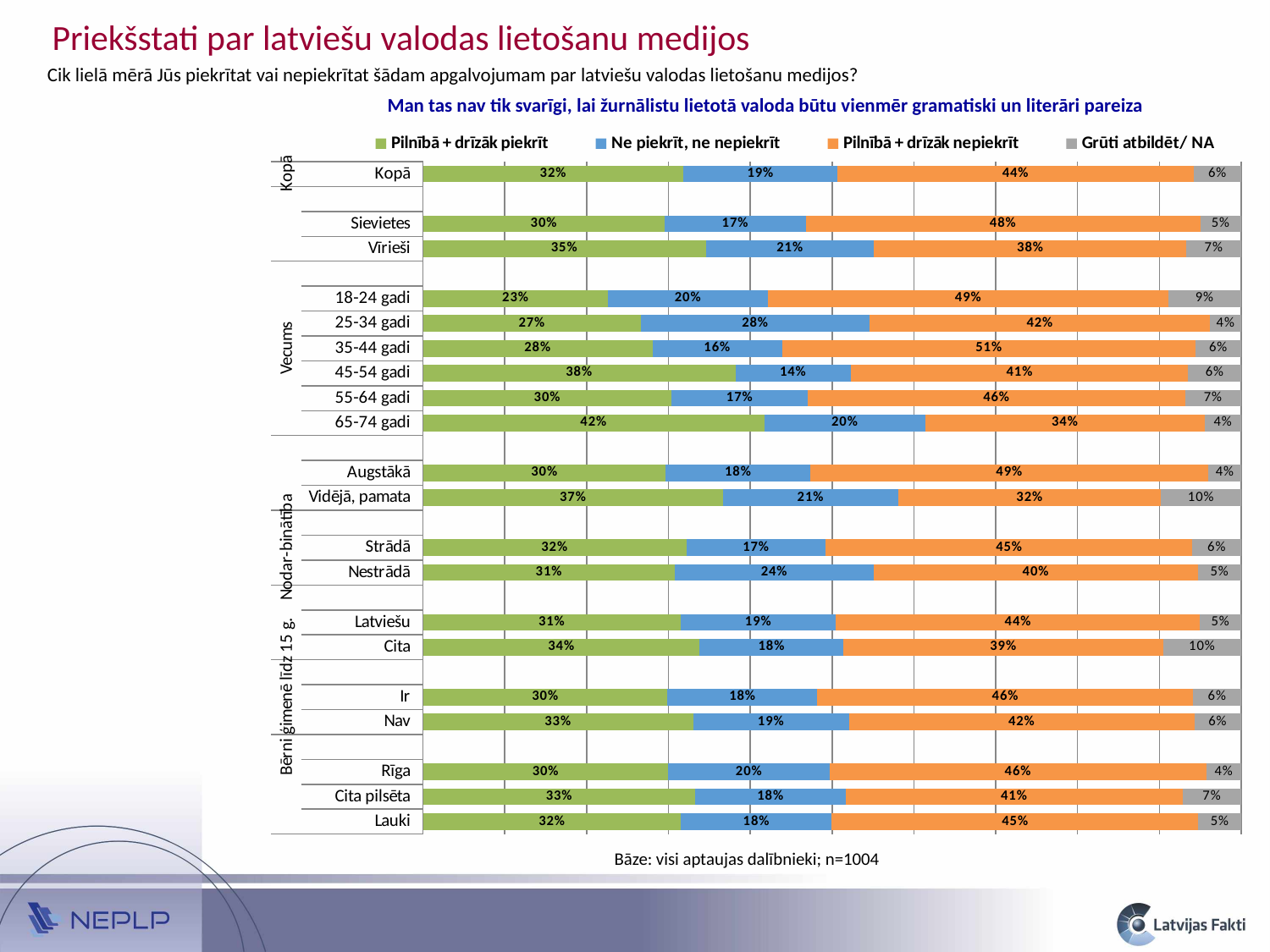
What kind of chart is shown on the slide? Stacked bar chart What is the total of the stacked bar for Rīga? 100% What is the value of "Pilnībā + drīzāk piekrīt" for Kopā? 32% What is the value of "Grūti atbildēt/ NA" for Vidējā, pamata? 10% What is the value of "Pilnībā + drīzāk nepiekrīt" for 35-44 gadi? 51% What is the difference between the "Pilnībā + drīzāk nepiekrīt" values for Sievietes and Vīrieši? 10% Among the age groups (Vecums), which has the highest value for "Pilnībā + drīzāk piekrīt"? 65-74 gadi How many categories (rows) are plotted in the chart? 20 What is the value of "Ne piekrīt, ne nepiekrīt" for Nestrādā? 24% Among the age groups (Vecums), which has the lowest value for "Pilnībā + drīzāk piekrīt"? 18-24 gadi How many series does the legend list? 4 Which has a larger "Ne piekrīt, ne nepiekrīt" value, 25-34 gadi or 45-54 gadi? 25-34 gadi